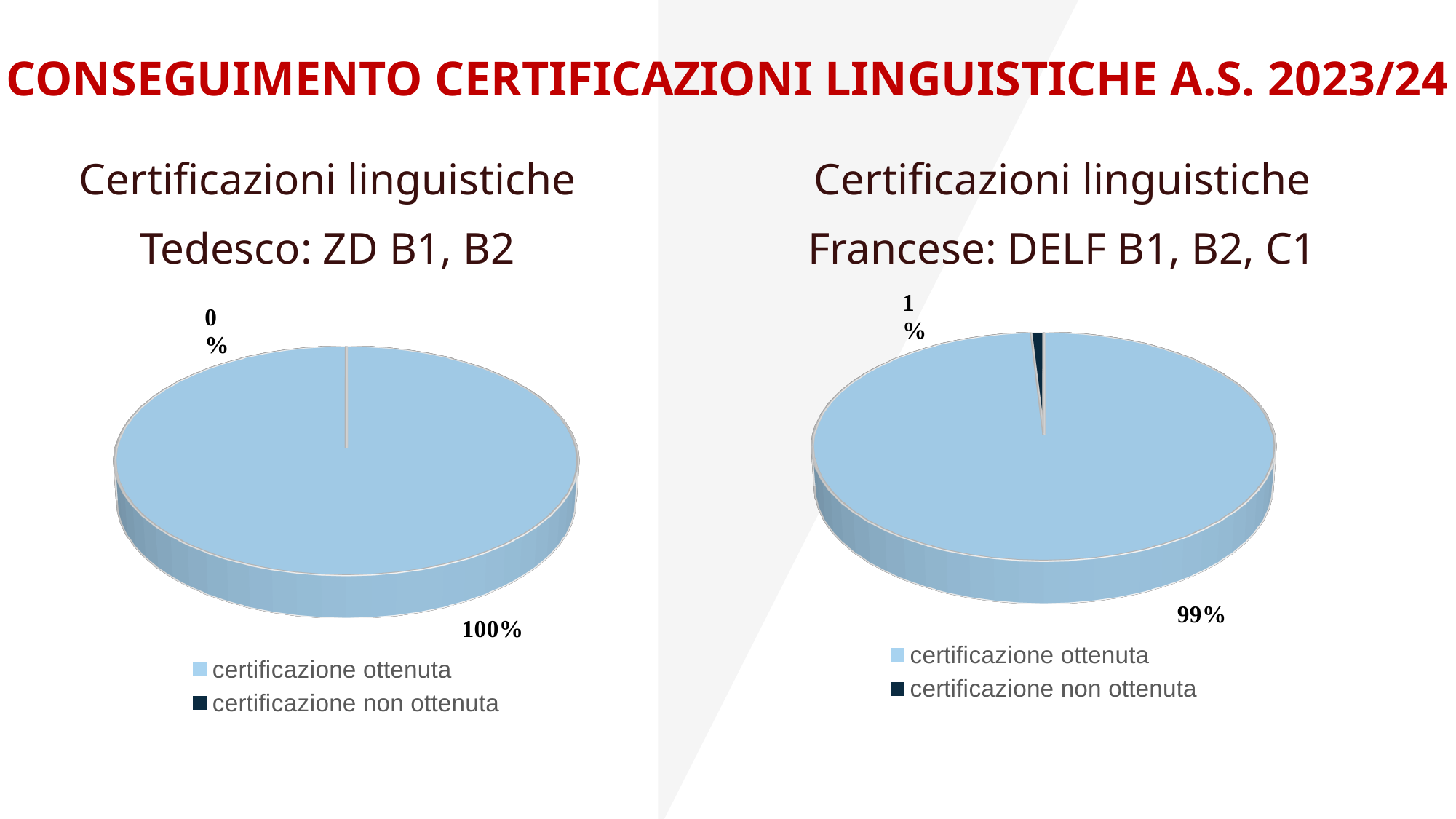
In the 'Certificazioni linguistiche Francese: DELF B1, B2, C1' chart, which category has the smallest slice? certificazione non ottenuta In the 'Certificazioni linguistiche Francese: DELF B1, B2, C1' chart, what is the difference between the 'certificazione ottenuta' and 'certificazione non ottenuta' shares? 98% In the 'Certificazioni linguistiche Francese: DELF B1, B2, C1' chart, which category has the largest slice? certificazione ottenuta Which is larger: the 'certificazione ottenuta' share in the Tedesco chart or the 'certificazione ottenuta' share in the Francese chart? Tedesco chart What is the title of the chart on the right side of the slide? Certificazioni linguistiche Francese: DELF B1, B2, C1 In the 'Certificazioni linguistiche Tedesco: ZD B1, B2' chart, what share of the pie is 'certificazione non ottenuta'? 0% How many categories does the legend of the 'Certificazioni linguistiche Francese: DELF B1, B2, C1' chart list? 2 What kind of chart is the 'Certificazioni linguistiche Tedesco: ZD B1, B2' chart? Pie chart In the 'Certificazioni linguistiche Francese: DELF B1, B2, C1' chart, what share of the pie is 'certificazione ottenuta'? 99% In the 'Certificazioni linguistiche Tedesco: ZD B1, B2' chart, what share of the pie is 'certificazione ottenuta'? 100% In the 'Certificazioni linguistiche Tedesco: ZD B1, B2' chart, what colour represents 'certificazione ottenuta'? Light blue